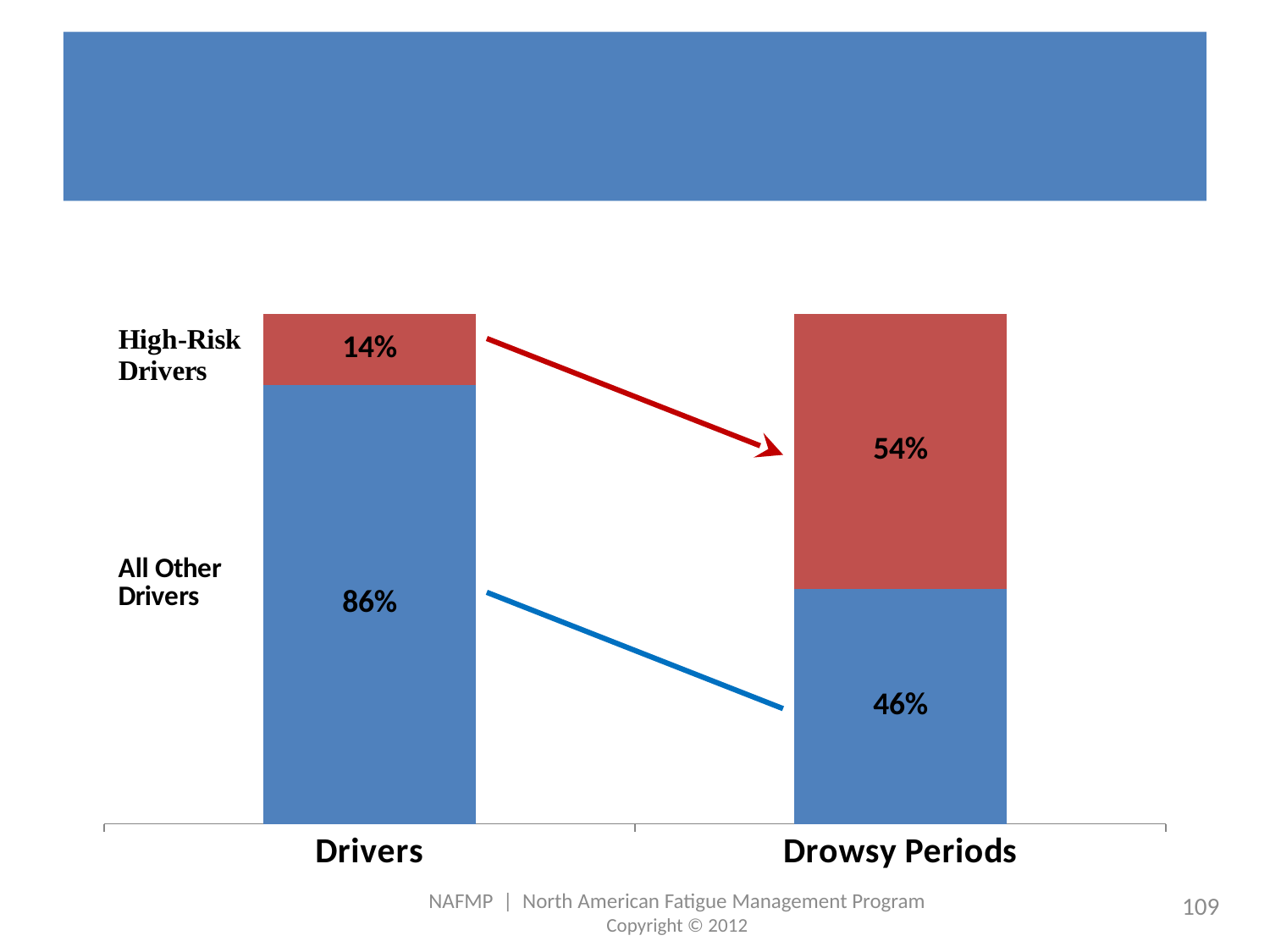
Which category has the larger All Other Drivers segment, Drivers or Drowsy Periods? Drivers How many categories are shown on the x axis? 2 What kind of chart is shown on the slide? Stacked bar chart What colour represents High-Risk Drivers in the chart? Red What share of Drowsy Periods is attributed to High-Risk Drivers? 54% What is the difference between the High-Risk Drivers share of Drowsy Periods and their share of Drivers? 40% What share of Drowsy Periods is attributed to All Other Drivers? 46% What percentage of Drivers are All Other Drivers? 86% What is the difference between the All Other Drivers share of Drivers and their share of Drowsy Periods? 40% Which category has the larger High-Risk Drivers segment, Drivers or Drowsy Periods? Drowsy Periods What percentage of Drivers are High-Risk Drivers? 14% What is the total of the two segments in the Drowsy Periods bar? 100%